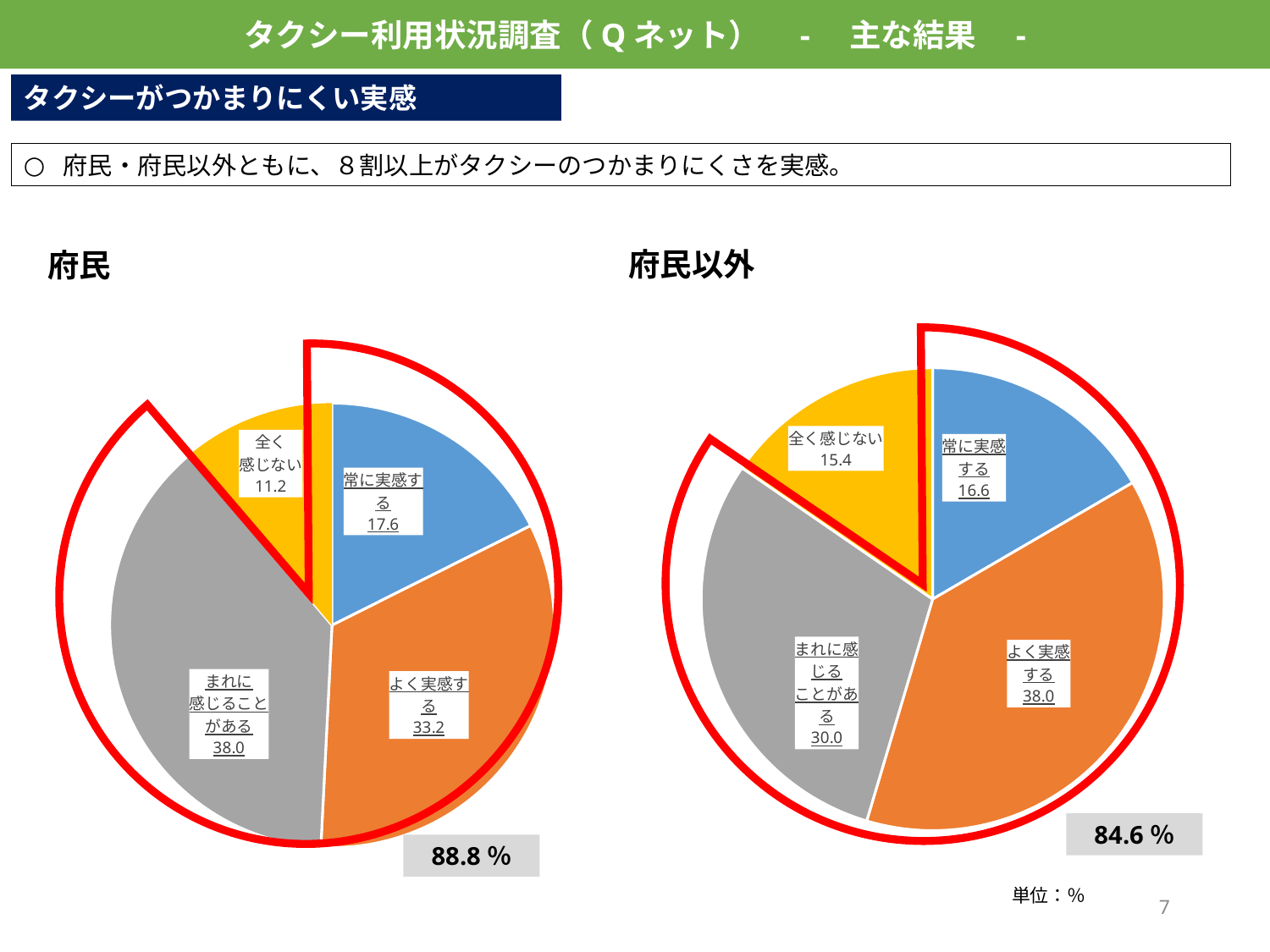
In the 府民 pie chart, what is the combined share of the three slices outlined in red (常に実感する, よく実感する, まれに感じることがある)? 88.8% In the 府民以外 pie chart, what is the value for 全く感じない? 15.4 In the 府民以外 pie chart, what is the difference between よく実感する and 常に実感する? 21.4 What type of chart is used for 府民? Pie chart What unit is indicated for the values in the charts? % Which is larger in the 府民 pie chart: よく実感する or 常に実感する? よく実感する In the 府民 pie chart, which category has the largest share? まれに感じることがある In the 府民以外 pie chart, which category has the smallest share? 全く感じない How many slices does the 府民以外 pie chart have? 4 In the 府民 pie chart, what is the difference between まれに感じることがある and 全く感じない? 26.8 In the 府民 pie chart, what is the value for 常に実感する? 17.6 In the 府民以外 pie chart, which category has the largest share? よく実感する